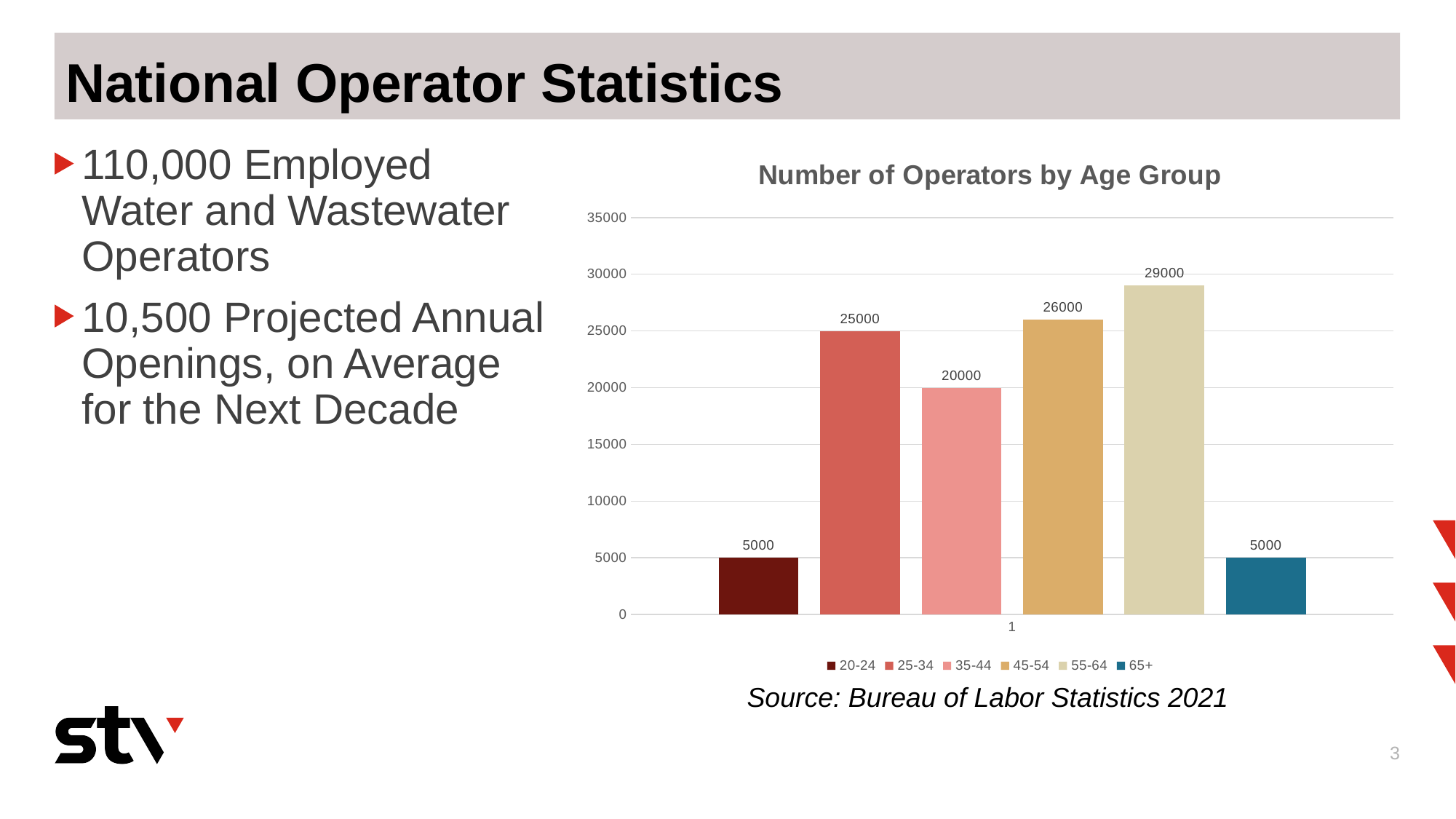
What is the difference between the number of operators in the 55-64 and 25-34 age groups? 4000 How many series does the legend list? 6 What is the number of operators in the 35-44 age group? 20000 Is the value for the 20-24 age group greater or less than 10000? less What is the number of operators in the 55-64 age group? 29000 What is the number of operators in the 45-54 age group? 26000 Which age group has the highest number of operators? 55-64 Which age group has more operators, 45-54 or 25-34? 45-54 What is the title of the chart? Number of Operators by Age Group What is the difference between the number of operators in the 25-34 and 35-44 age groups? 5000 How many age groups are shown in the chart? 6 What kind of chart is shown on the slide? bar chart